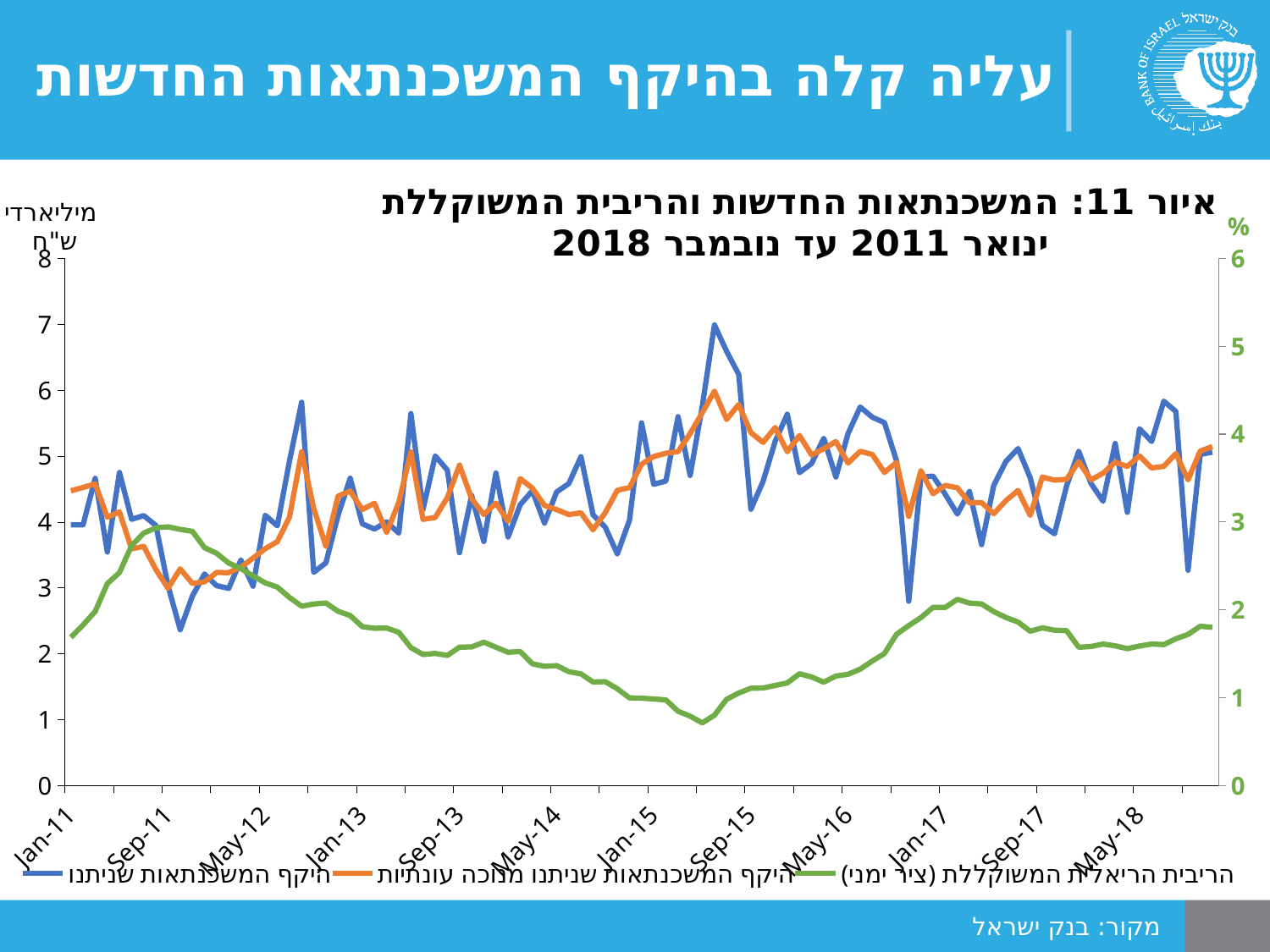
Does the green series (הריבית הריאלית המשוקללת) rise or fall between May-12 and Sep-15? fall Is the value of the green series (הריבית הריאלית המשוקללת) at May-12 greater or less than 2 on the right axis? greater What is the title of the chart? איור 11: המשכנתאות החדשות והריבית המשוקללת ינואר 2011 עד נובמבר 2018 Around which x-axis label does the blue series (היקף המשכנתאות שניתנו) reach its highest point? Sep-15 Which series is plotted on the right axis according to the legend? הריבית הריאלית המשוקללת (ציר ימני) Does the green series (הריבית הריאלית המשוקללת) rise or fall between Jan-11 and May-12? rise Is the peak value of the blue series (היקף המשכנתאות שניתנו) around Sep-15 greater or less than 6 on the left axis? greater Is the value of the green series (הריבית הריאלית המשוקללת) at Jan-11 greater or less than 2 on the right axis? less What kind of chart is shown on the slide? line chart How many series does the legend list? 3